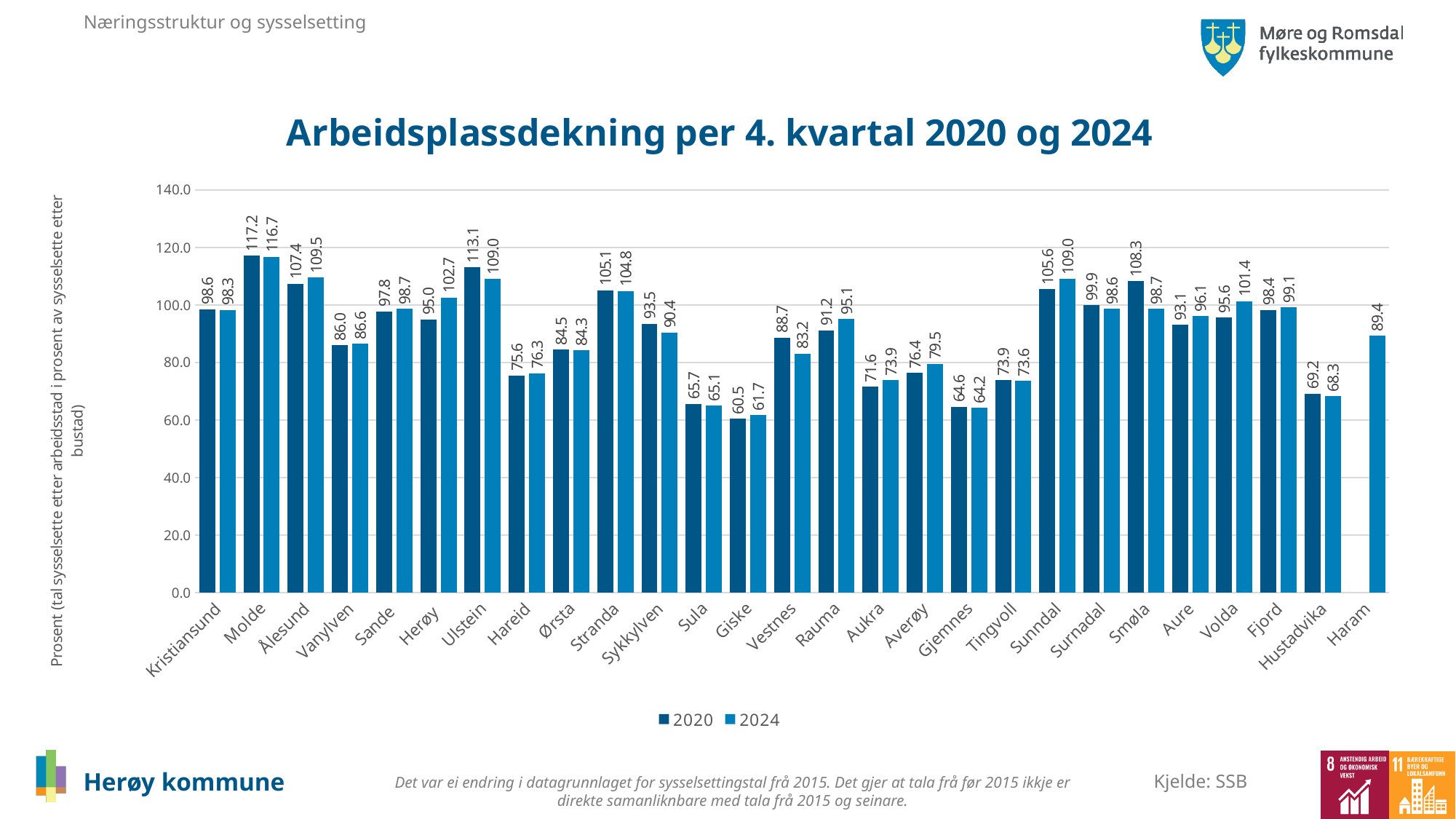
How many municipalities are shown on the x axis? 27 What kind of chart is shown on the slide? Bar chart Which municipality has the highest value in 2020? Molde What is the value for Molde in 2020? 117.2 Which is larger for Ulstein: the 2020 value or the 2024 value? 2020 What is the value for Haram in 2024? 89.4 How many series does the legend list? 2 What is the value for Herøy in 2024? 102.7 What is the difference between the 2020 and 2024 values for Smøla? 9.6 Is the 2024 value for Sunndal greater or less than 100.0? greater What is the difference between the 2024 and 2020 values for Herøy? 7.7 Which municipality has the lowest value in 2024? Giske